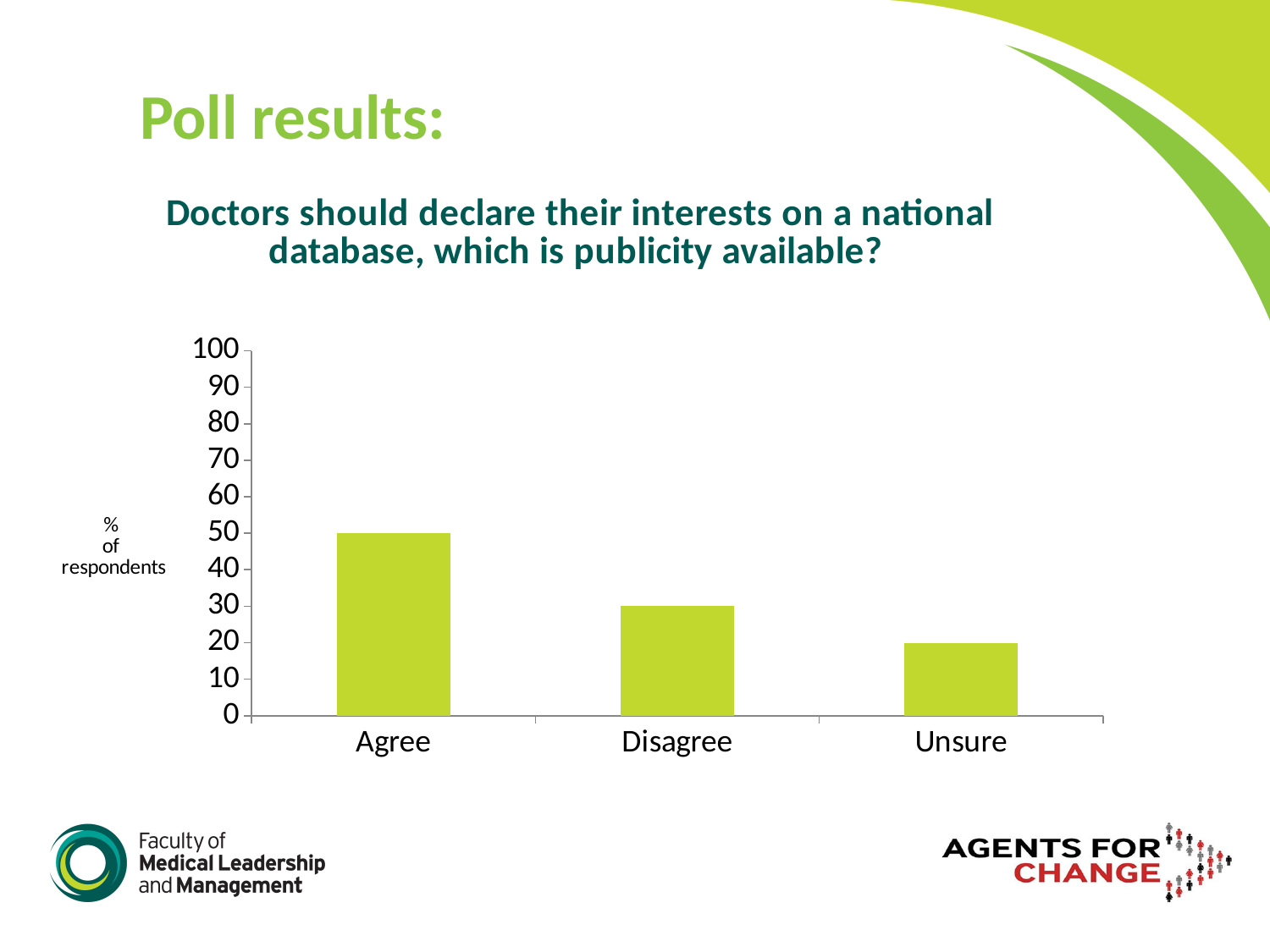
Which category has the lowest percentage of respondents? Unsure Which is larger, the value for Disagree or the value for Unsure? Disagree What is the difference in percentage points between Agree and Disagree? 20 What percentage of respondents chose Agree? 50 How many categories are shown on the x axis of the chart? 3 What is the label on the vertical axis of the chart? % of respondents Do the values rise or fall moving from Agree to Unsure along the x axis? fall What percentage of respondents chose Unsure? 20 What is the difference in percentage points between Disagree and Unsure? 10 What kind of chart is shown on the slide? bar chart What percentage of respondents chose Disagree? 30 Which category has the highest percentage of respondents? Agree